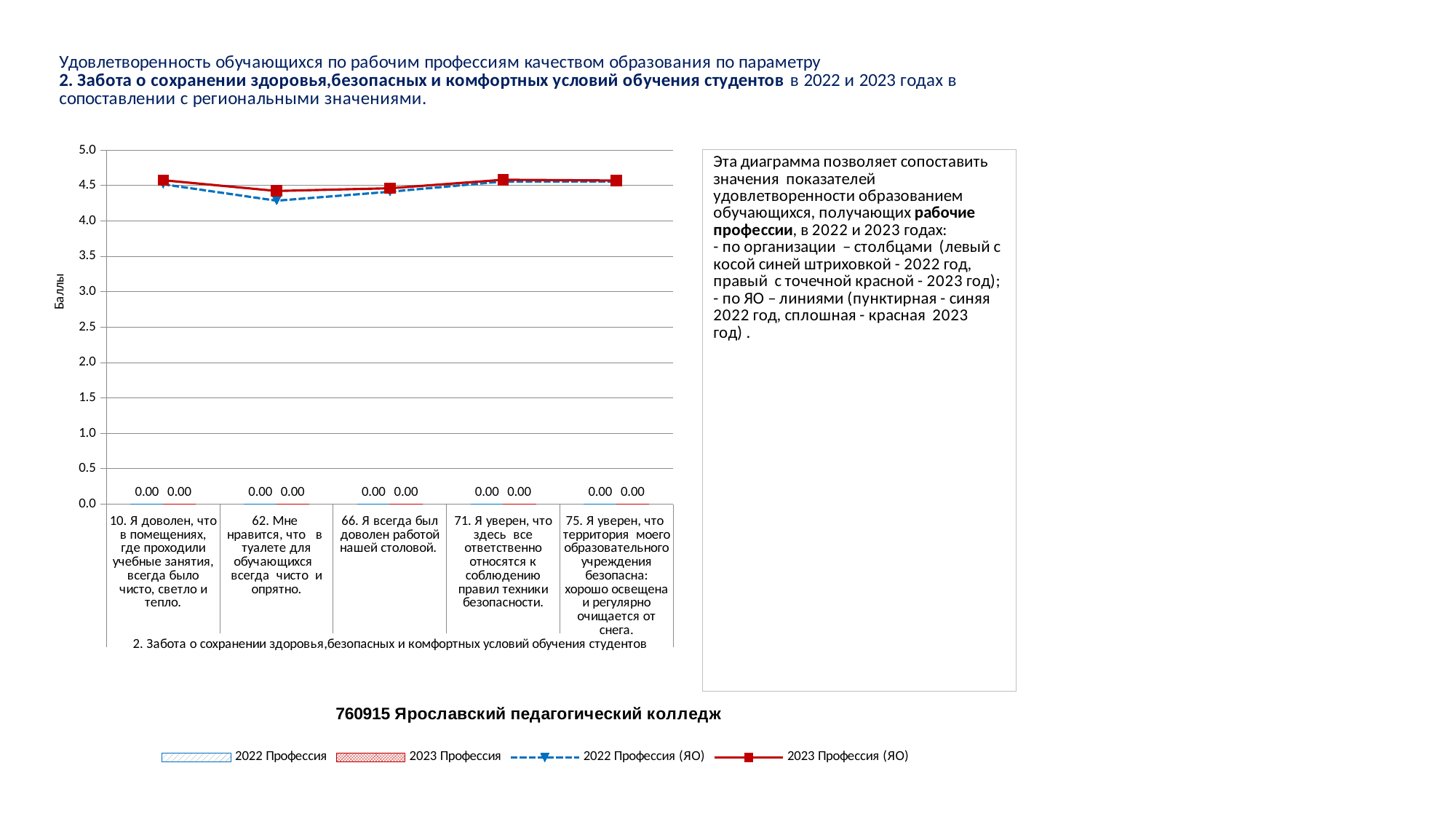
What is the value of the 2023 Профессия bar for category "75. Я уверен, что территория моего образовательного учреждения безопасна: хорошо освещена и регулярно очищается от снега."? 0.00 What organisation name is printed in bold below the chart? 760915 Ярославский педагогический колледж For category "62. Мне нравится, что в туалете для обучающихся всегда чисто и опрятно.", which line is higher: 2022 Профессия (ЯО) or 2023 Профессия (ЯО)? 2023 Профессия (ЯО) Is the value of the 2022 Профессия (ЯО) line for category "62. Мне нравится, что в туалете для обучающихся всегда чисто и опрятно." greater or less than 4.5? less How many series does the chart legend list? 4 How many categories are shown on the x axis of the chart? 5 Is the value of the 2023 Профессия (ЯО) line for category "71. Я уверен, что здесь все ответственно относятся к соблюдению правил техники безопасности." greater or less than 4.5? greater Is the value of the 2023 Профессия (ЯО) line for category "10. Я доволен, что в помещениях, где проходили учебные занятия, всегда было чисто, светло и тепло." greater or less than 4.0? greater What is the value of the 2022 Профессия bar for category "10. Я доволен, что в помещениях, где проходили учебные занятия, всегда было чисто, светло и тепло."? 0.00 What kind of chart is shown on the slide? Combined bar and line chart Which category has the lowest value on the 2022 Профессия (ЯО) line? 62. Мне нравится, что в туалете для обучающихся всегда чисто и опрятно. What is the label of the vertical axis of the chart? Баллы